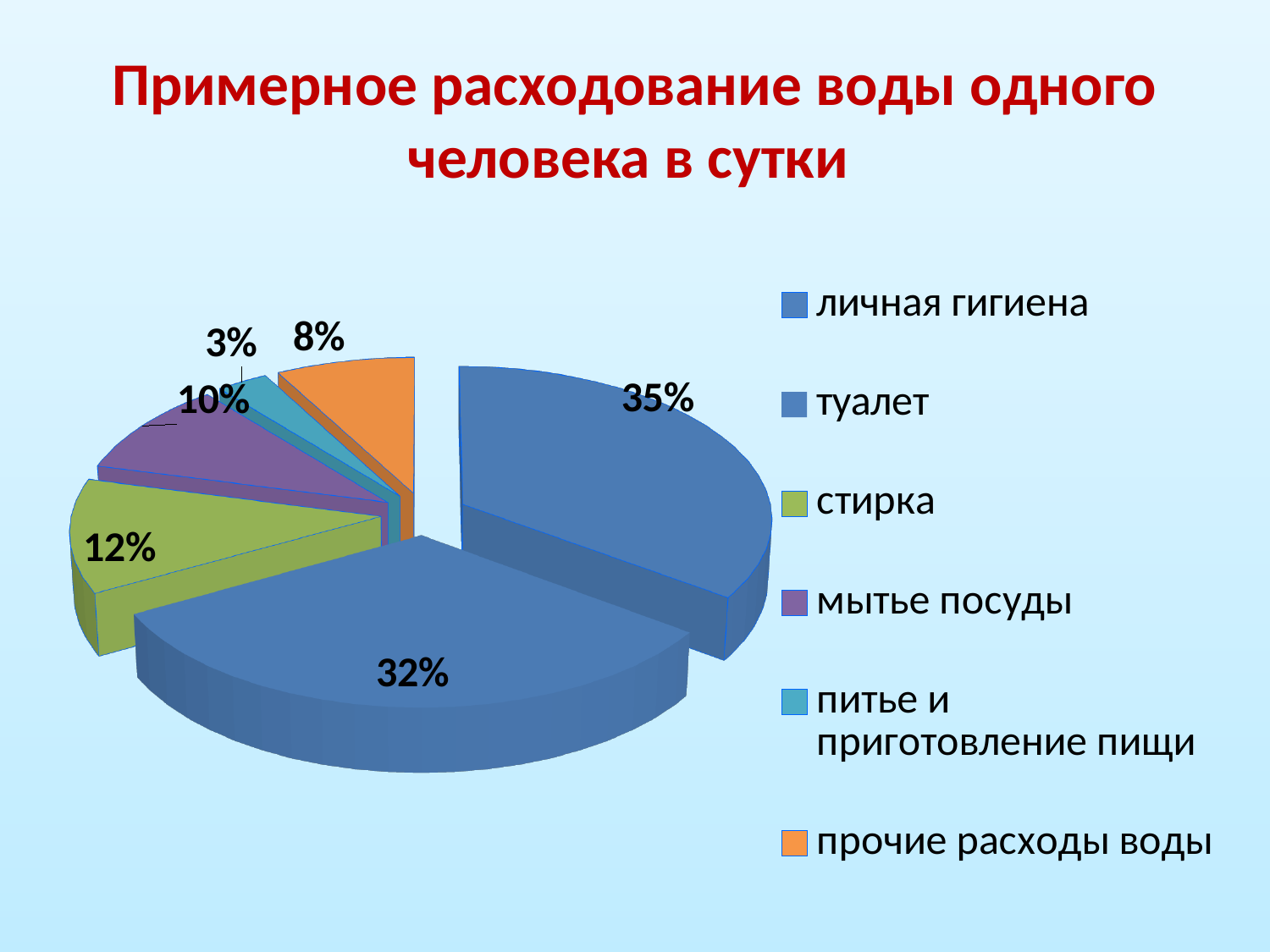
What kind of chart is shown on the slide? pie chart How many categories does the legend of the pie chart list? 6 What colour is the slice for прочие расходы воды? orange What is the title of the chart on the slide? Примерное расходование воды одного человека в сутки What percentage of water use is shown for стирка? 12% What is the largest percentage label shown on the pie chart? 35% What percentage of water use is shown for мытье посуды? 10% What is the difference between the shares for стирка and мытье посуды? 2% Which has a larger share, стирка or прочие расходы воды? стирка What percentage of water use is shown for прочие расходы воды? 8% What percentage of water use is shown for питье и приготовление пищи? 3% Which category has the smallest share of the pie? питье и приготовление пищи